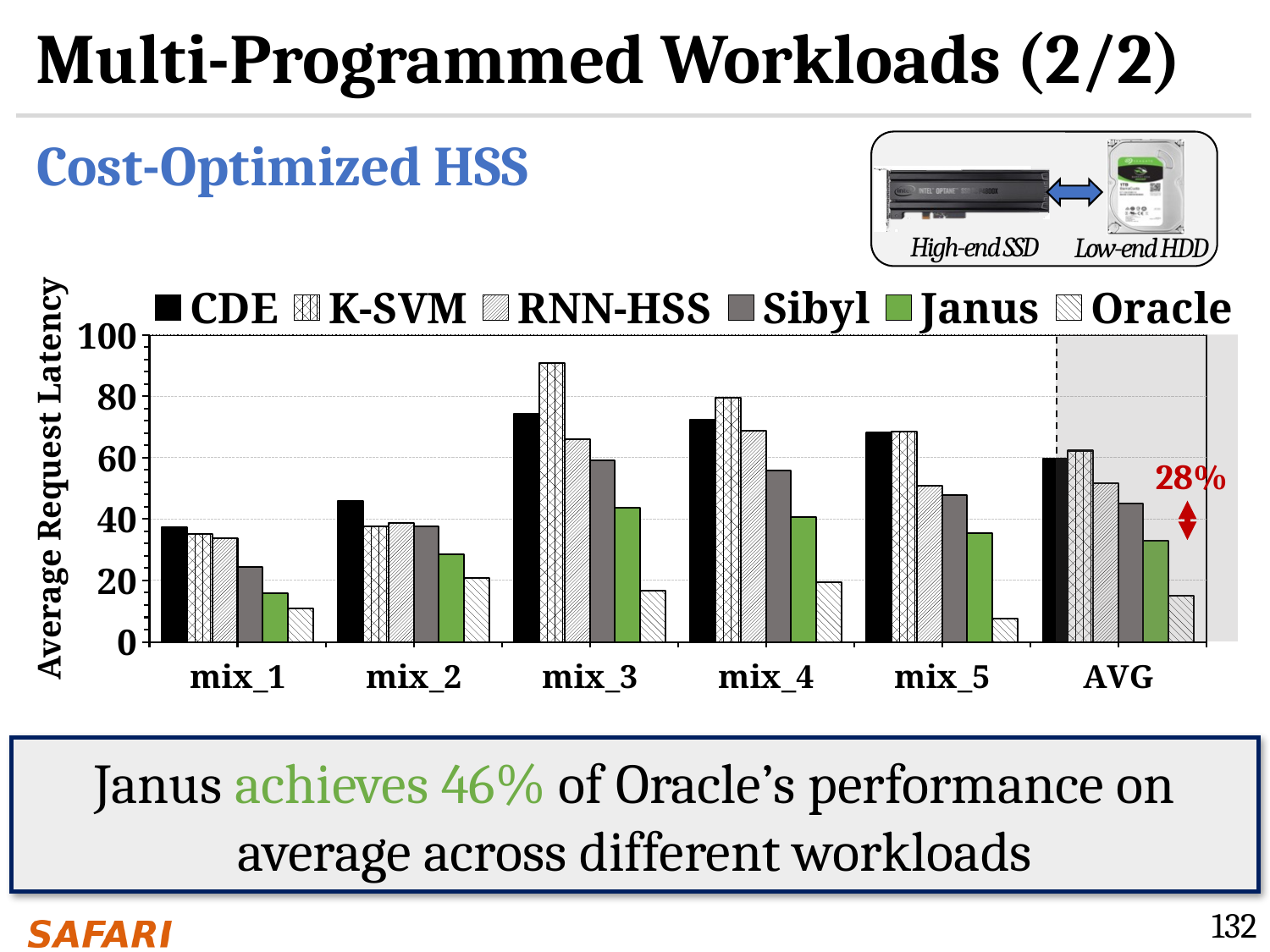
Is the K-SVM value for mix_3 greater or less than 80? greater How many series does the legend list? 6 What percentage is annotated between the Janus and Oracle bars in the AVG group? 28% Which series has the highest Average Request Latency for mix_3? K-SVM Is the Oracle value for mix_5 greater or less than 20? less Is the Janus value for AVG greater or less than 40? less What kind of chart is shown on the slide? bar chart How many workload categories are shown along the x axis? 6 For mix_4, which is larger: the CDE value or the Janus value? CDE For which workload is the K-SVM bar the tallest? mix_3 Which series has the lowest Average Request Latency for mix_5? Oracle